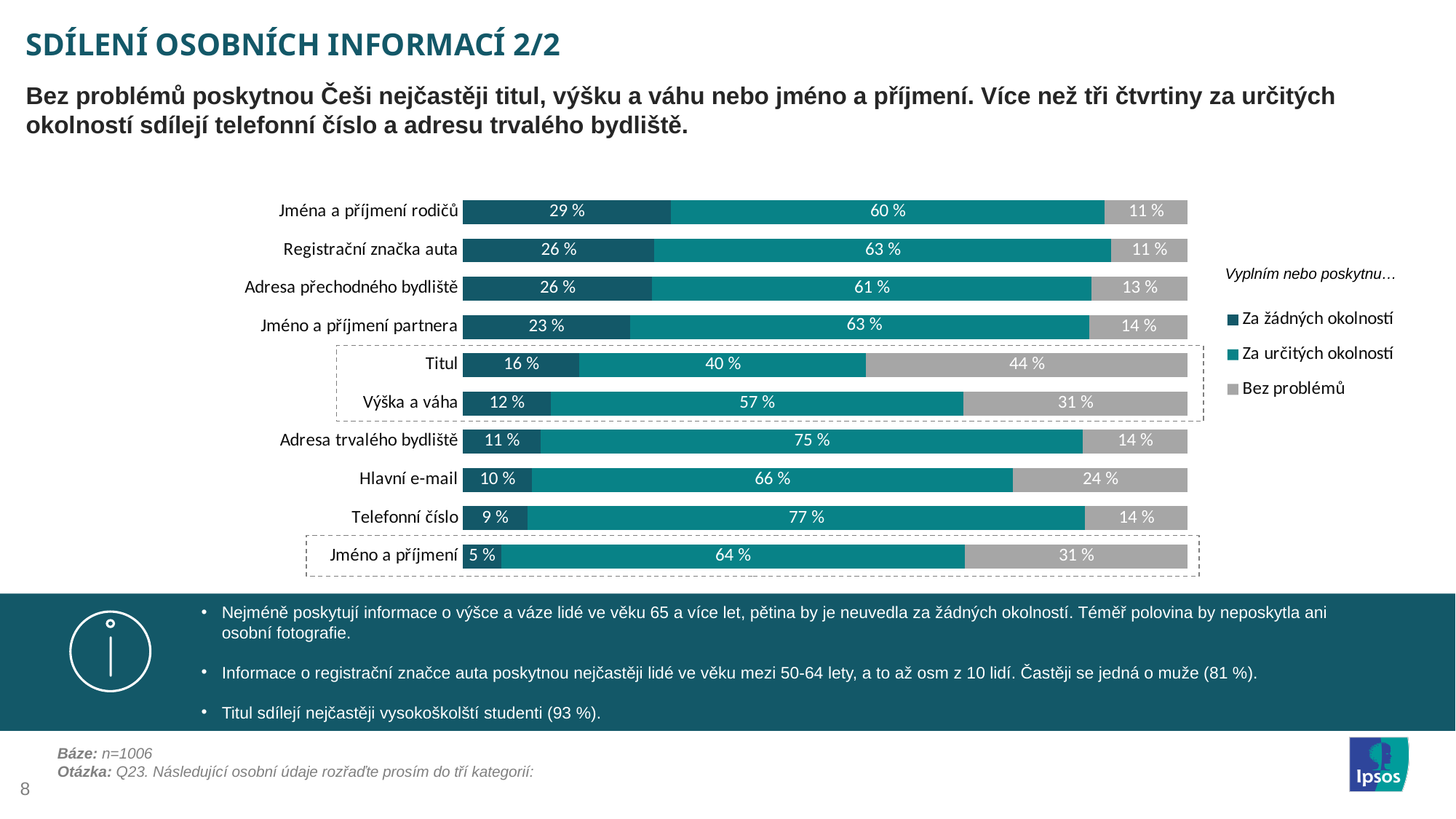
How many series does the legend list? 3 Which is larger: the 'Za určitých okolností' value for 'Adresa trvalého bydliště' or for 'Hlavní e-mail'? Adresa trvalého bydliště How many categories are shown on the chart? 10 Which category has the lowest 'Za určitých okolností' value? Titul What is the 'Bez problémů' value for 'Titul'? 44 % What is the difference between the 'Bez problémů' values for 'Titul' and 'Výška a váha'? 13 % What is the 'Za žádných okolností' value for 'Jména a příjmení rodičů'? 29 % Which category has the lowest 'Za žádných okolností' value? Jméno a příjmení What percentage of respondents would share their 'Telefonní číslo' 'Za určitých okolností'? 77 % Which category has the highest 'Bez problémů' value? Titul What kind of chart is shown on the slide? Stacked bar chart What is the total of the stacked bar for 'Hlavní e-mail'? 100 %